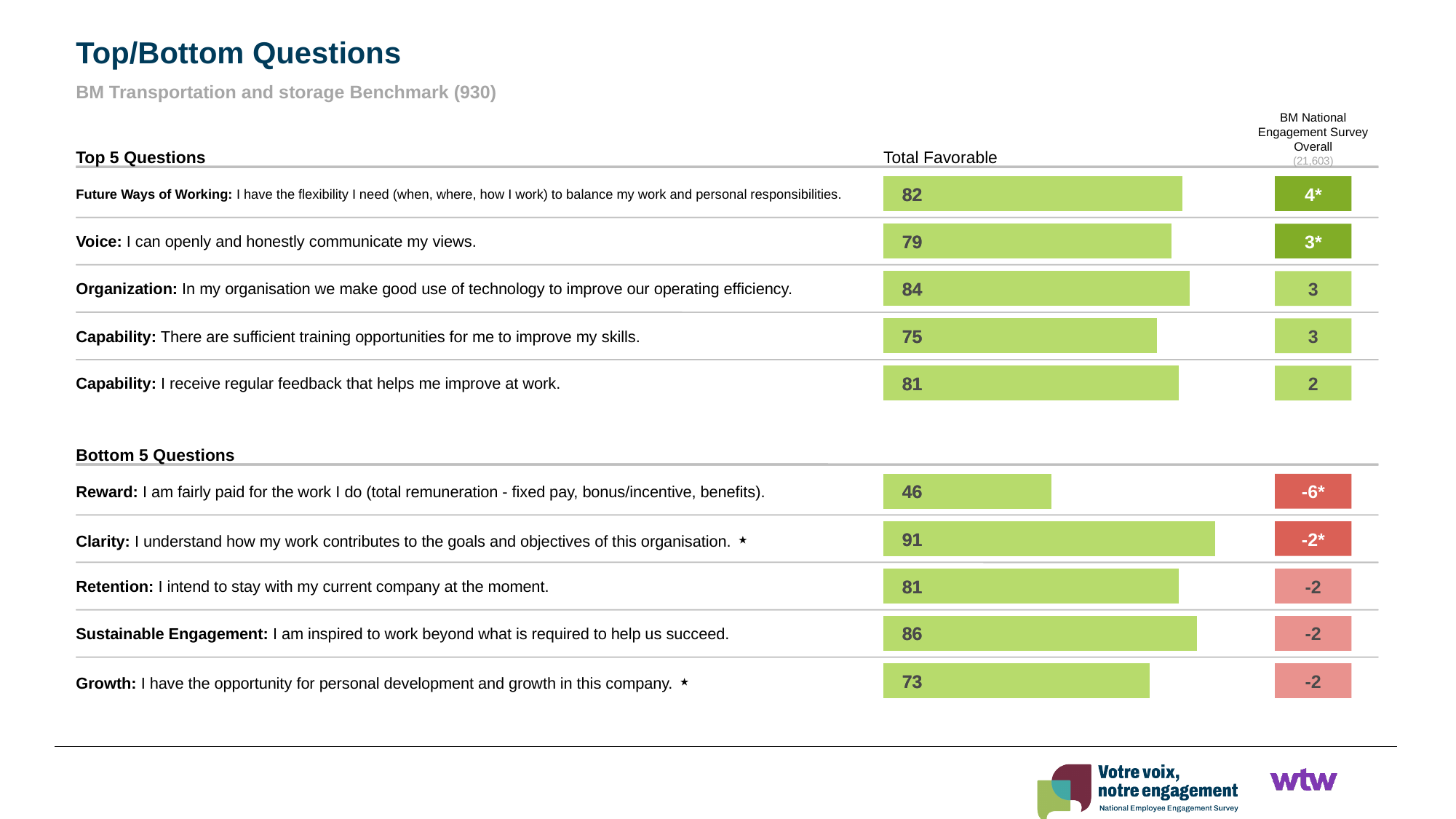
In the Top 5 Questions chart, what is the Total Favorable value for the Voice item "I can openly and honestly communicate my views"? 79 In the Top 5 Questions chart, what is the BM National Engagement Survey Overall comparison value for the Future Ways of Working item? 4* What type of chart is used to show the Total Favorable values on this slide? Bar chart In the Bottom 5 Questions chart, what is the BM National Engagement Survey Overall comparison value for the Reward item? -6* What is the subtitle shown under the slide title "Top/Bottom Questions"? BM Transportation and storage Benchmark (930) How many items are plotted in the Bottom 5 Questions chart? 5 In the Top 5 Questions chart, which has a higher Total Favorable: the Future Ways of Working item or the Capability item about regular feedback? Future Ways of Working In the Bottom 5 Questions chart, which item has the highest Total Favorable value? Clarity: I understand how my work contributes to the goals and objectives of this organisation. In the Top 5 Questions chart, which item has the highest Total Favorable value? Organization: In my organisation we make good use of technology to improve our operating efficiency. In the Bottom 5 Questions chart, what is the Total Favorable value for the Reward item about being fairly paid? 46 In the Top 5 Questions chart, which item has the lowest Total Favorable value? Capability: There are sufficient training opportunities for me to improve my skills. In the Bottom 5 Questions chart, what is the difference in Total Favorable between the Sustainable Engagement item (86) and the Growth item (73)? 13